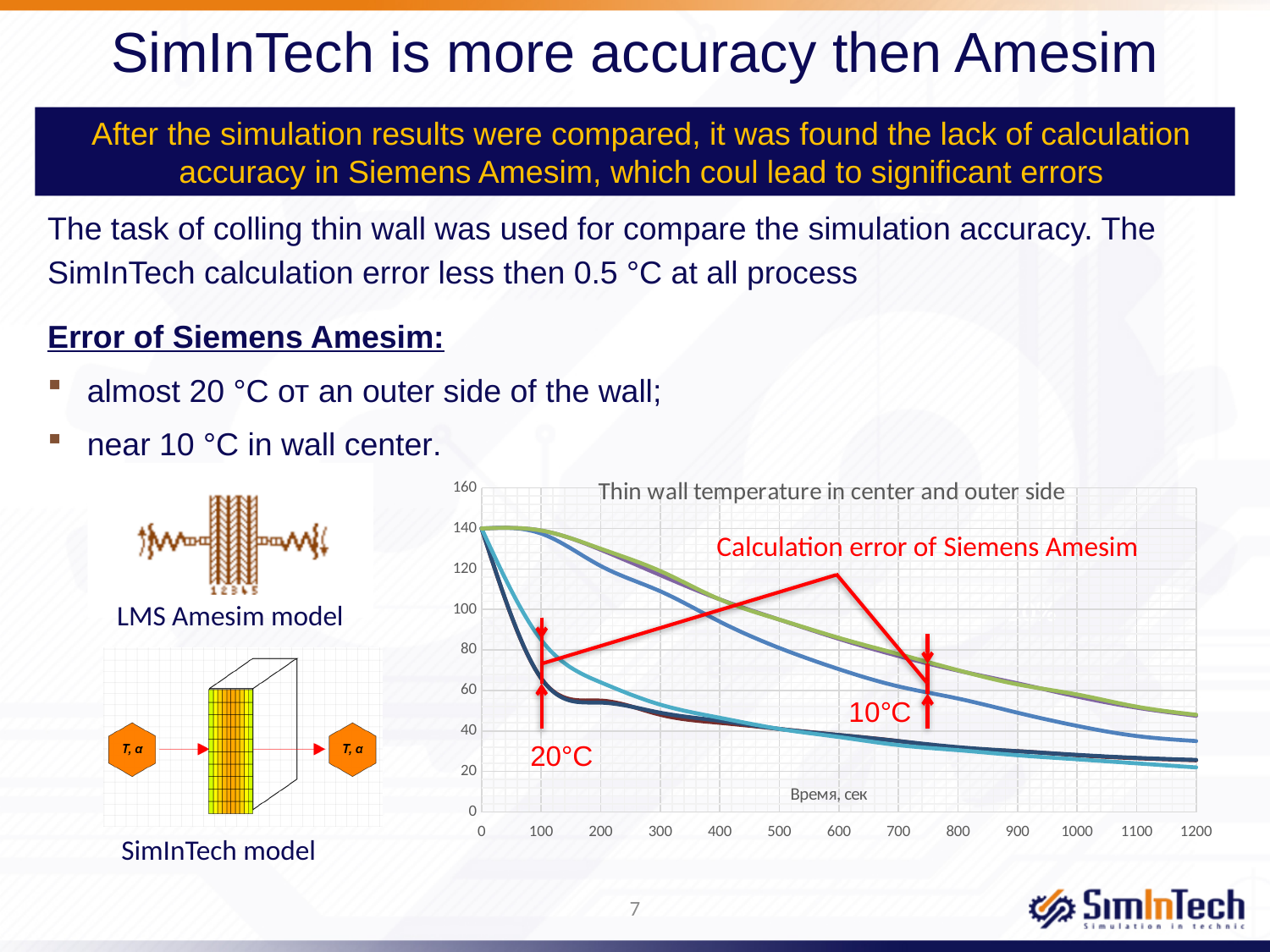
What calculation error of Siemens Amesim is annotated on the chart near time 100? 20°C At time 100, is the value of the lowest curve greater or less than 80? less At time 1200, are the temperature curves greater or less than 60? less What kind of chart is shown on the slide? Line chart What calculation error of Siemens Amesim is annotated on the chart near time 750? 10°C Do the temperature curves rise or fall as time increases along the x axis? Fall What is the label of the x axis of the chart? Время, сек What is the maximum value shown on the y axis of the chart? 160 What is the maximum time value shown on the x axis of the chart? 1200 At time 100, is the value of the uppermost curve greater or less than 120? greater What temperature value do the curves start from at time 0? 140 What is the title of the chart? Thin wall temperature in center and outer side